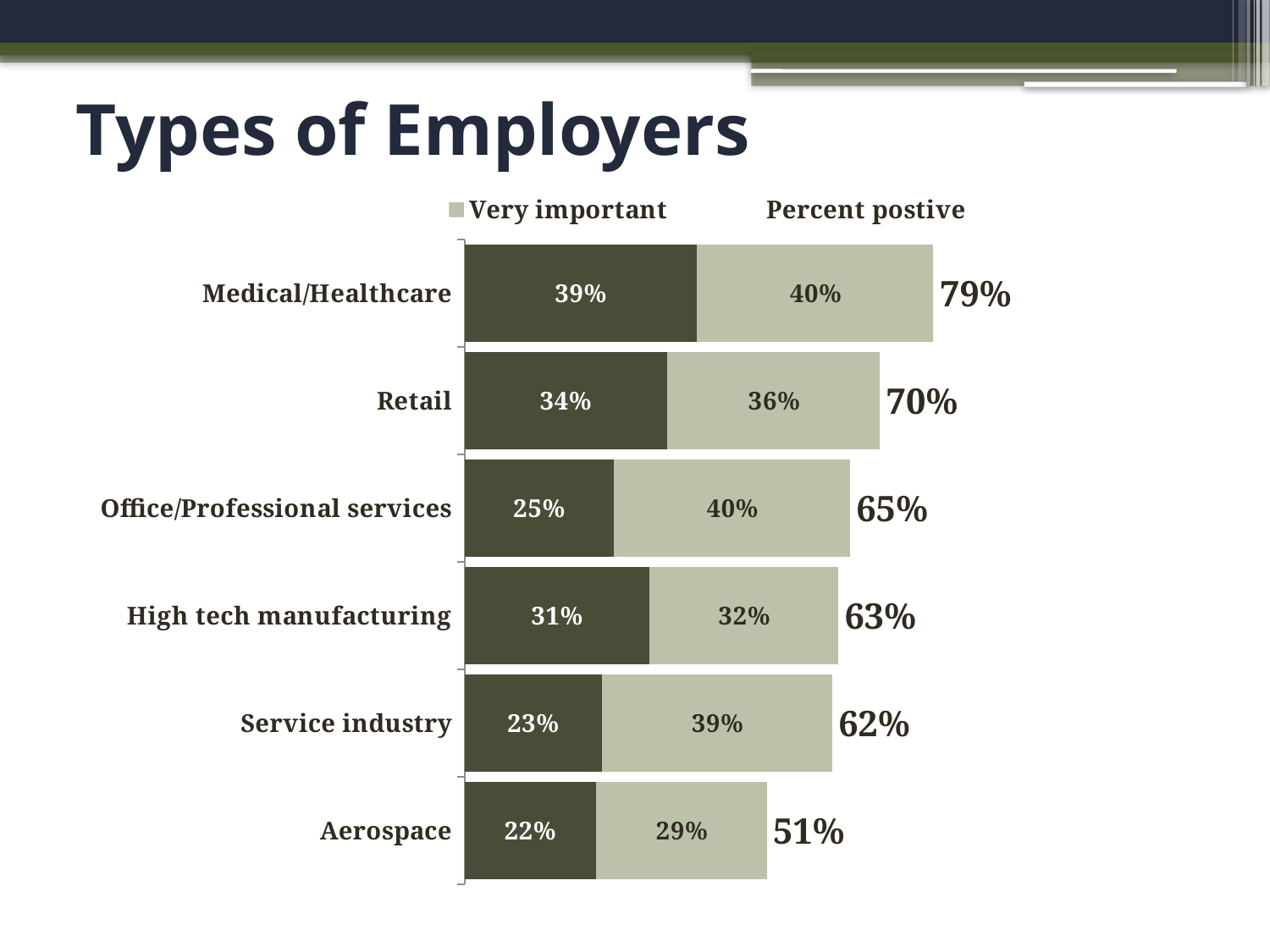
Which employer type has the highest total percentage? Medical/Healthcare Which is larger, the 'Percent positive' value for Service industry or for High tech manufacturing? High tech manufacturing What is the difference between the 'Very important' values for Retail and Office/Professional services? 4% Which employer type has the lowest 'Very important' value? Aerospace What is the 'Very important' value for Medical/Healthcare? 40% How many employer types are shown in the chart? 6 What is the total of the stacked bar for Retail? 70% What is the 'Percent positive' value for Aerospace? 51% What is the 'Very important' value for Service industry? 39% What is the total of the stacked bar for High tech manufacturing? 63% What kind of chart is shown on the slide? Stacked bar chart How many series does the legend list? 2